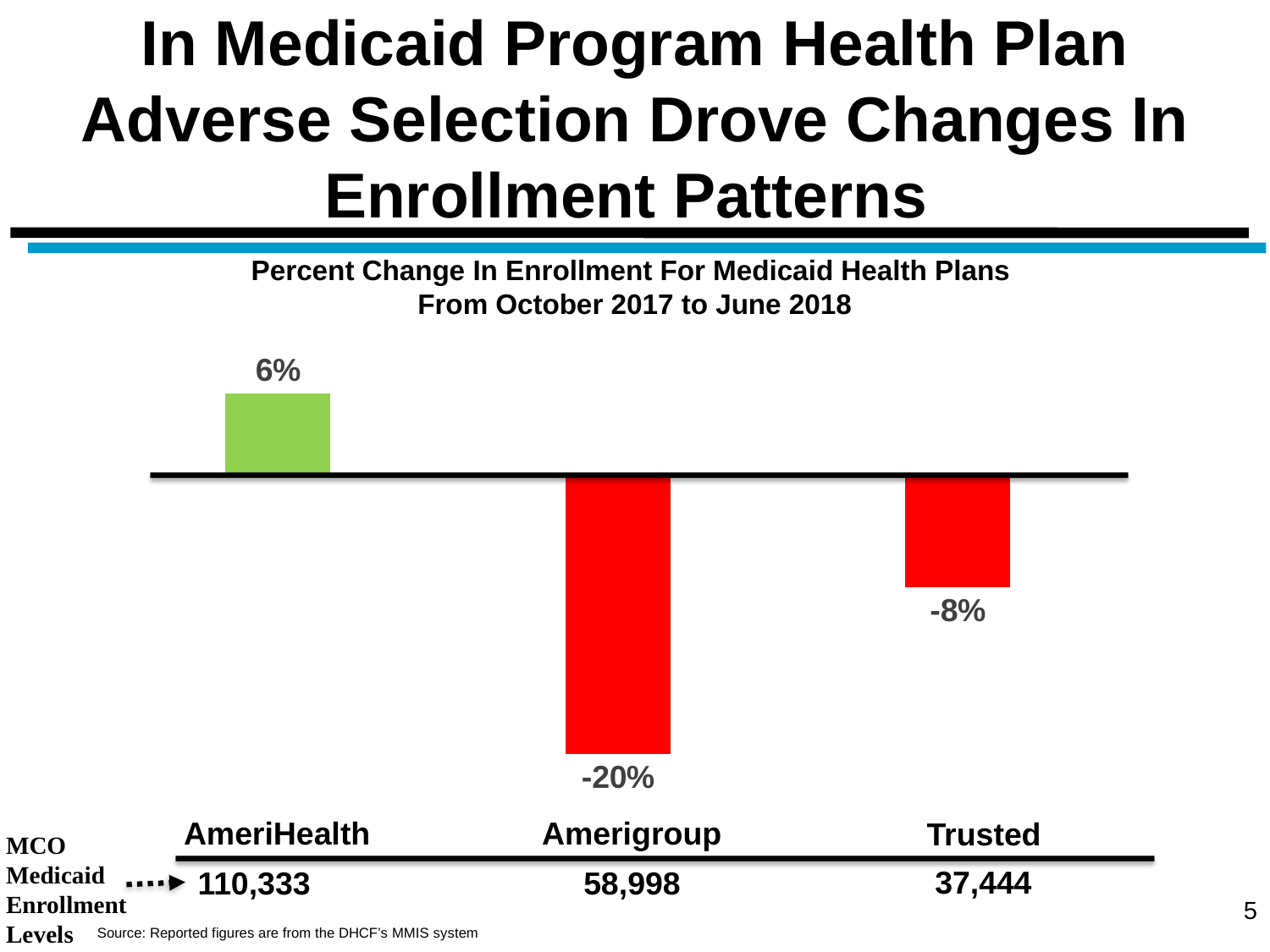
What is the percent change in enrollment for AmeriHealth? 6% What is the difference in percentage points between the percent change for AmeriHealth and Trusted? 14 percentage points What is the percent change in enrollment for Trusted? -8% What is the title of the chart? Percent Change In Enrollment For Medicaid Health Plans From October 2017 to June 2018 What is the MCO Medicaid enrollment level shown for AmeriHealth? 110,333 What is the percent change in enrollment for Amerigroup? -20% What kind of chart is shown on the slide? Bar chart Which health plan has the lowest percent change in enrollment? Amerigroup What is the MCO Medicaid enrollment level shown for Trusted? 37,444 Which health plan has the highest percent change in enrollment? AmeriHealth How many health plans are shown in the chart? 3